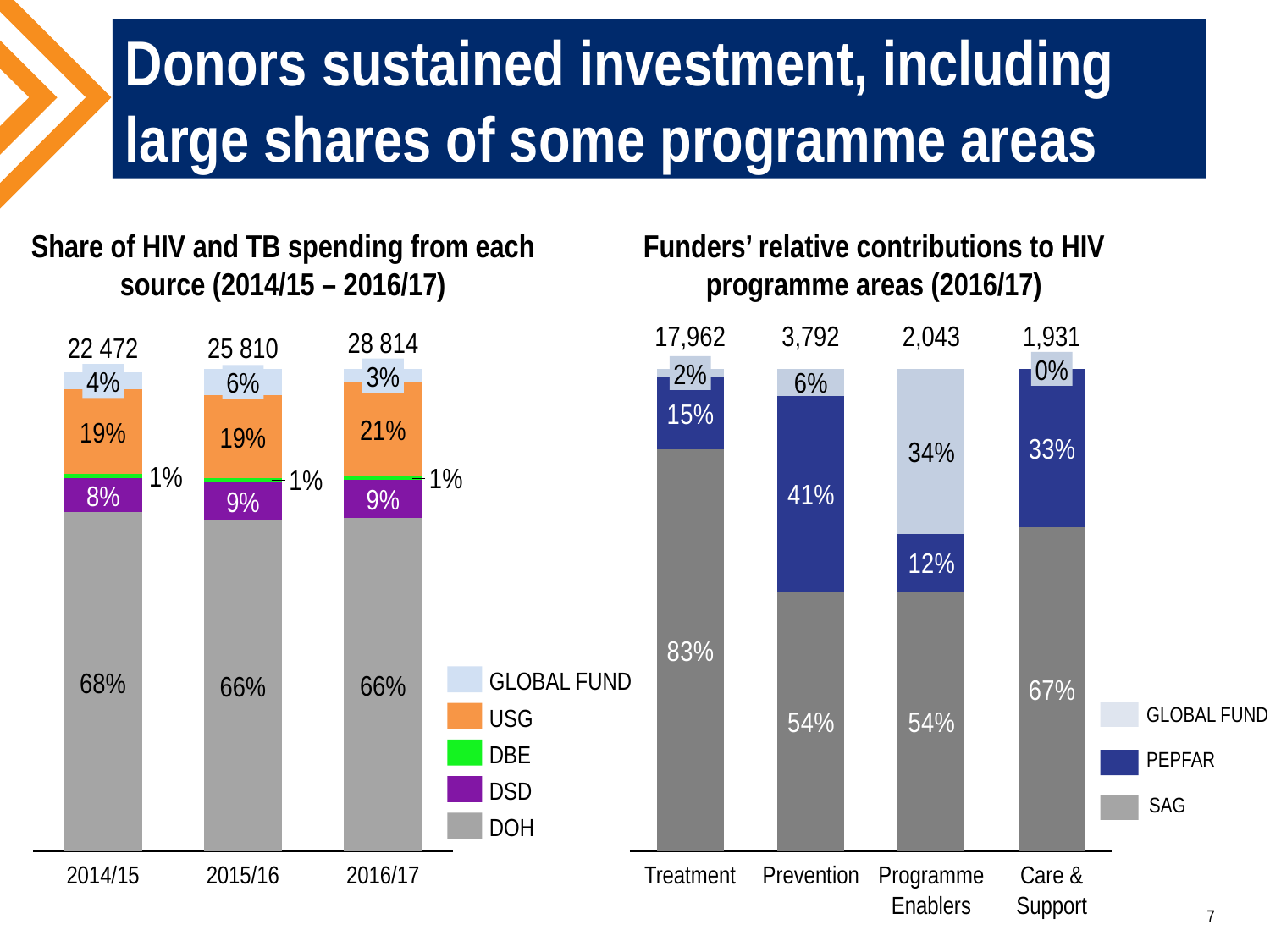
What type of chart is the 'Funders' relative contributions to HIV programme areas' chart? Stacked bar chart In the 'Share of HIV and TB spending from each source' chart, what is the DOH share in 2014/15? 68% In the 'Funders' relative contributions to HIV programme areas' chart, what is the GLOBAL FUND share for Programme Enablers? 34% In the 'Share of HIV and TB spending from each source' chart, which year has the highest total printed above its bar? 2016/17 In the 'Funders' relative contributions to HIV programme areas' chart, what is the PEPFAR share for Prevention? 41% In the 'Funders' relative contributions to HIV programme areas' chart, how many programme areas are shown? 4 In the 'Share of HIV and TB spending from each source' chart, what is the difference between the GLOBAL FUND share in 2015/16 and in 2016/17? 3% In the 'Funders' relative contributions to HIV programme areas' chart, which programme area has the highest SAG share? Treatment In the 'Share of HIV and TB spending from each source' chart, what total is printed above the 2015/16 bar? 25 810 In the 'Funders' relative contributions to HIV programme areas' chart, is the PEPFAR share larger for Treatment or for Care & Support? Care & Support In the 'Share of HIV and TB spending from each source' chart, what is the USG share in 2016/17? 21% In the 'Share of HIV and TB spending from each source' chart, how many series does the legend list? 5